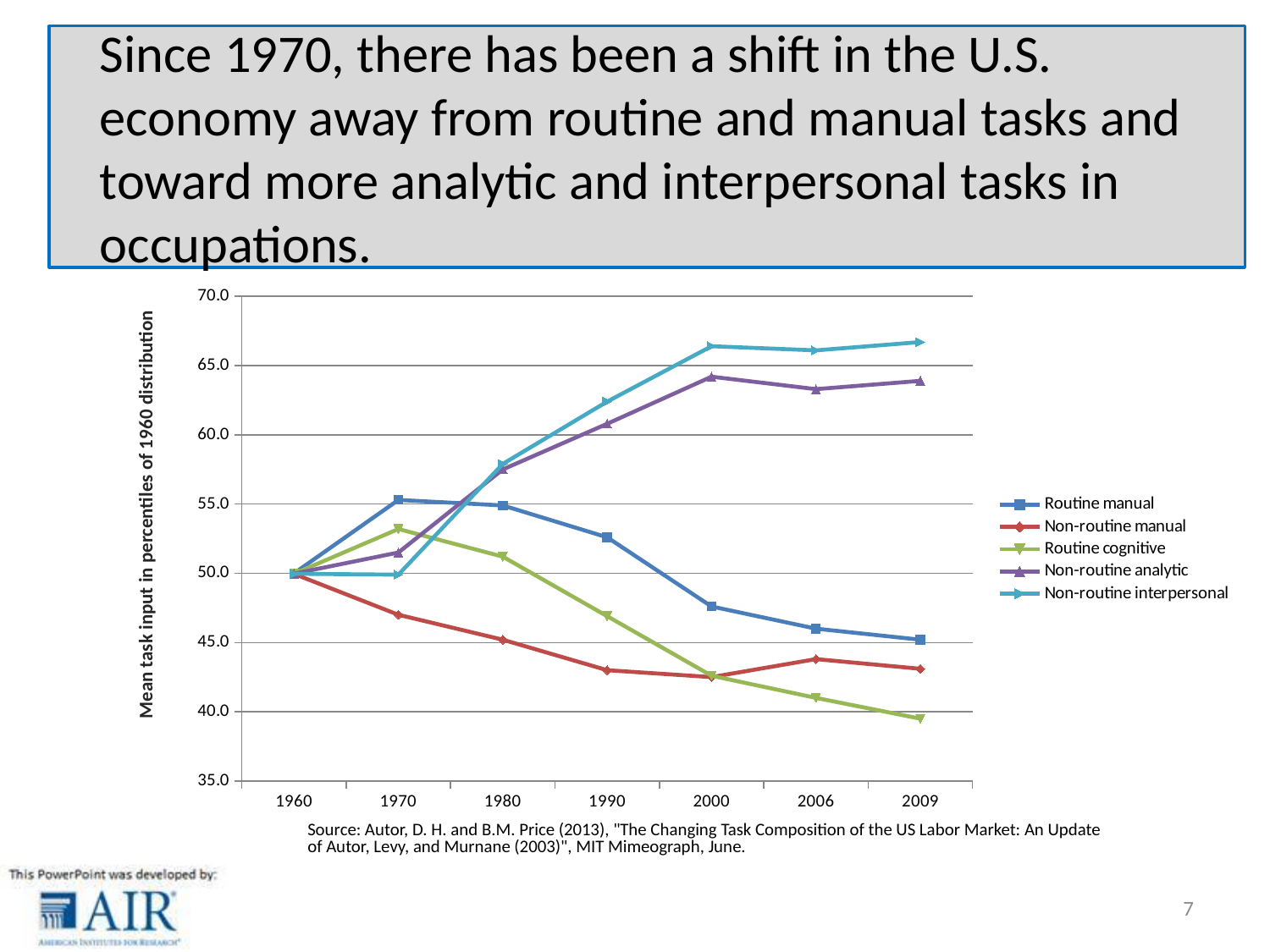
What is the value for Routine manual in 1960? 50.0 What is the title of the y axis? Mean task input in percentiles of 1960 distribution Is the value for Routine cognitive in 2009 greater or less than 40.0? less Which series has the lowest value in 2009? Routine cognitive How many series does the legend list? 5 What kind of chart is shown on the slide? line chart Is the value for Non-routine manual in 2000 greater or less than 45.0? less Which series has the highest value in 2009? Non-routine interpersonal How many years are shown on the x axis? 7 In 2000, which is larger: Non-routine analytic or Routine manual? Non-routine analytic Does the Routine cognitive series rise or fall from 1970 to 2009? fall Is the value for Non-routine interpersonal in 2009 greater or less than 65.0? greater